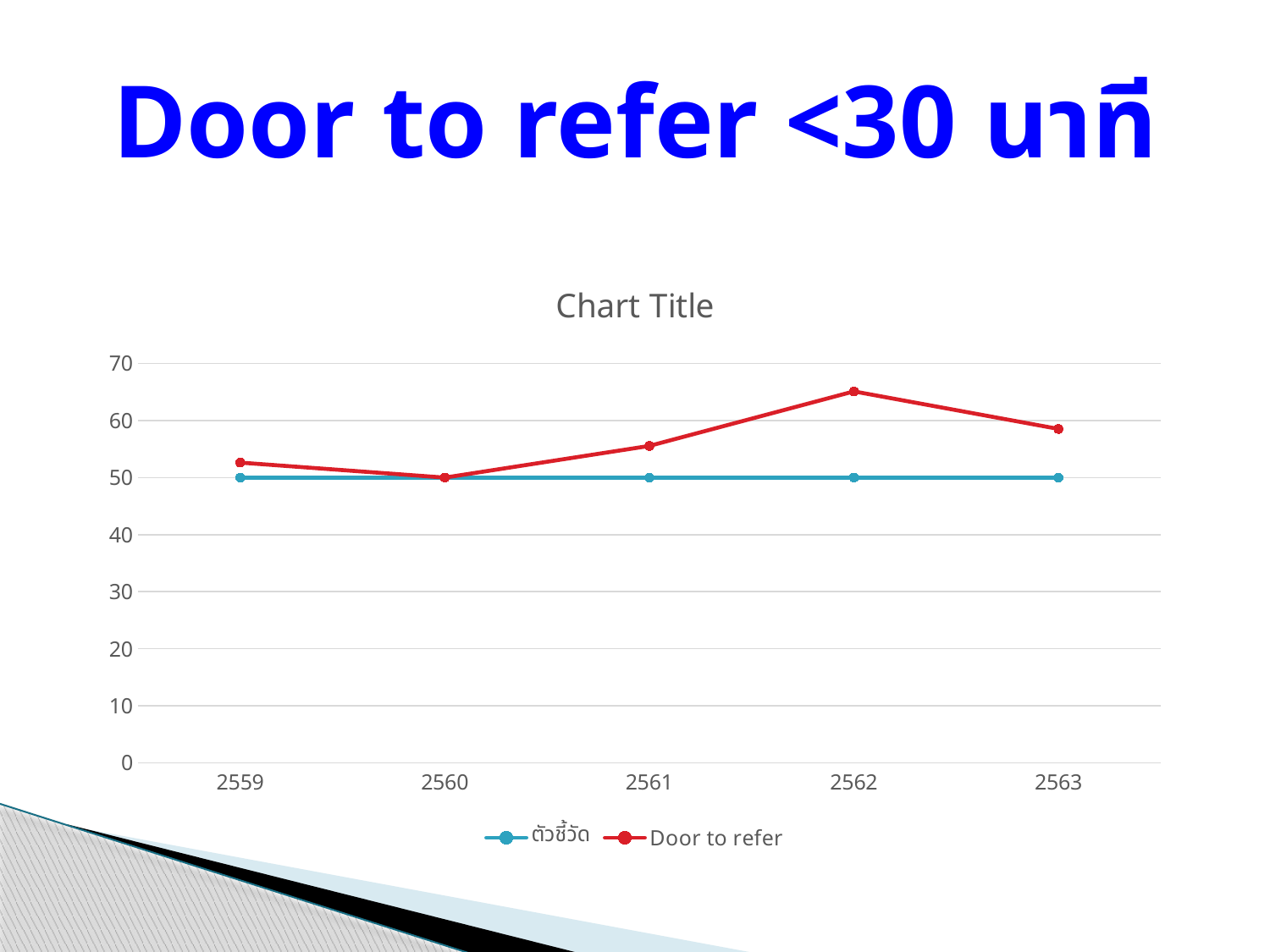
Does the Door to refer line rise or fall from 2560 to 2562? rise Which is larger, the Door to refer value for 2562 or for 2563? 2562 How many series does the legend list? 2 What is the title printed above the chart? Chart Title Is the Door to refer value for 2563 greater or less than 50? greater What kind of chart is shown on the slide? line chart How many years are shown on the x axis? 5 Is the Door to refer value for 2561 greater or less than 60? less Is the Door to refer value for 2562 greater or less than 60? greater In which year is the Door to refer value highest? 2562 In which year is the Door to refer value lowest? 2560 What is the value of the ตัวชี้วัด series in 2561? 50